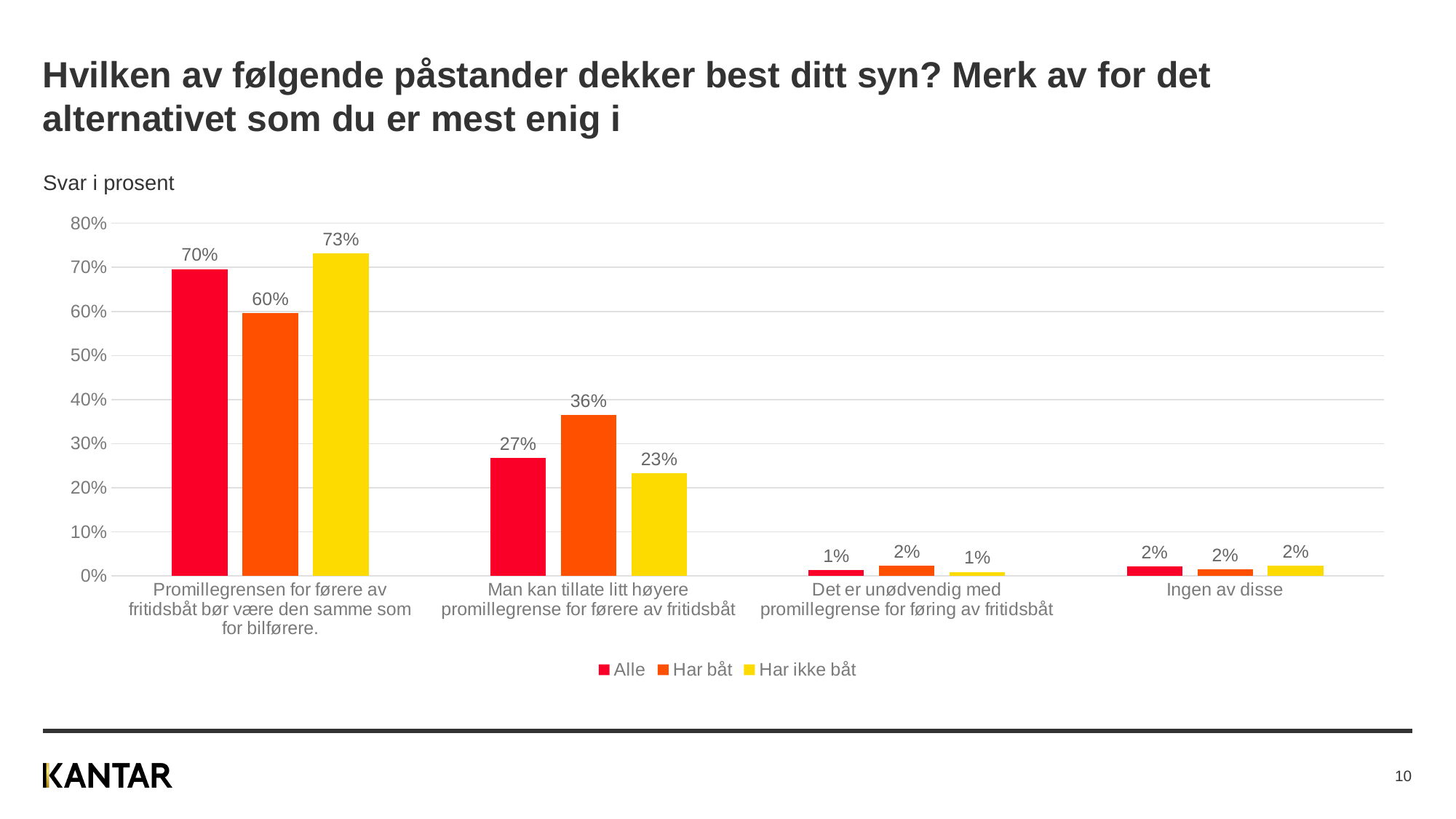
In the category "Man kan tillate litt høyere promillegrense for førere av fritidsbåt", which series has the larger value: "Alle" or "Har ikke båt"? Alle How many series does the legend list? 3 What is the value for "Har båt" in the category "Man kan tillate litt høyere promillegrense for førere av fritidsbåt"? 36% How many categories are shown on the x axis of the chart? 4 What is the value for "Alle" in the category "Det er unødvendig med promillegrense for føring av fritidsbåt"? 1% What is the difference between the "Har ikke båt" and "Har båt" values in the category "Promillegrensen for førere av fritidsbåt bør være den samme som for bilførere."? 13% What is the value for "Har ikke båt" in the category "Promillegrensen for førere av fritidsbåt bør være den samme som for bilførere."? 73% Which series is shown in yellow in the legend? Har ikke båt Is the value for "Har båt" in the category "Promillegrensen for førere av fritidsbåt bør være den samme som for bilførere." greater or less than 50%? greater What kind of chart is shown on the slide? Bar chart Which category has the highest value for the "Alle" series? Promillegrensen for førere av fritidsbåt bør være den samme som for bilførere. Which category has the lowest value for the "Har ikke båt" series? Det er unødvendig med promillegrense for føring av fritidsbåt